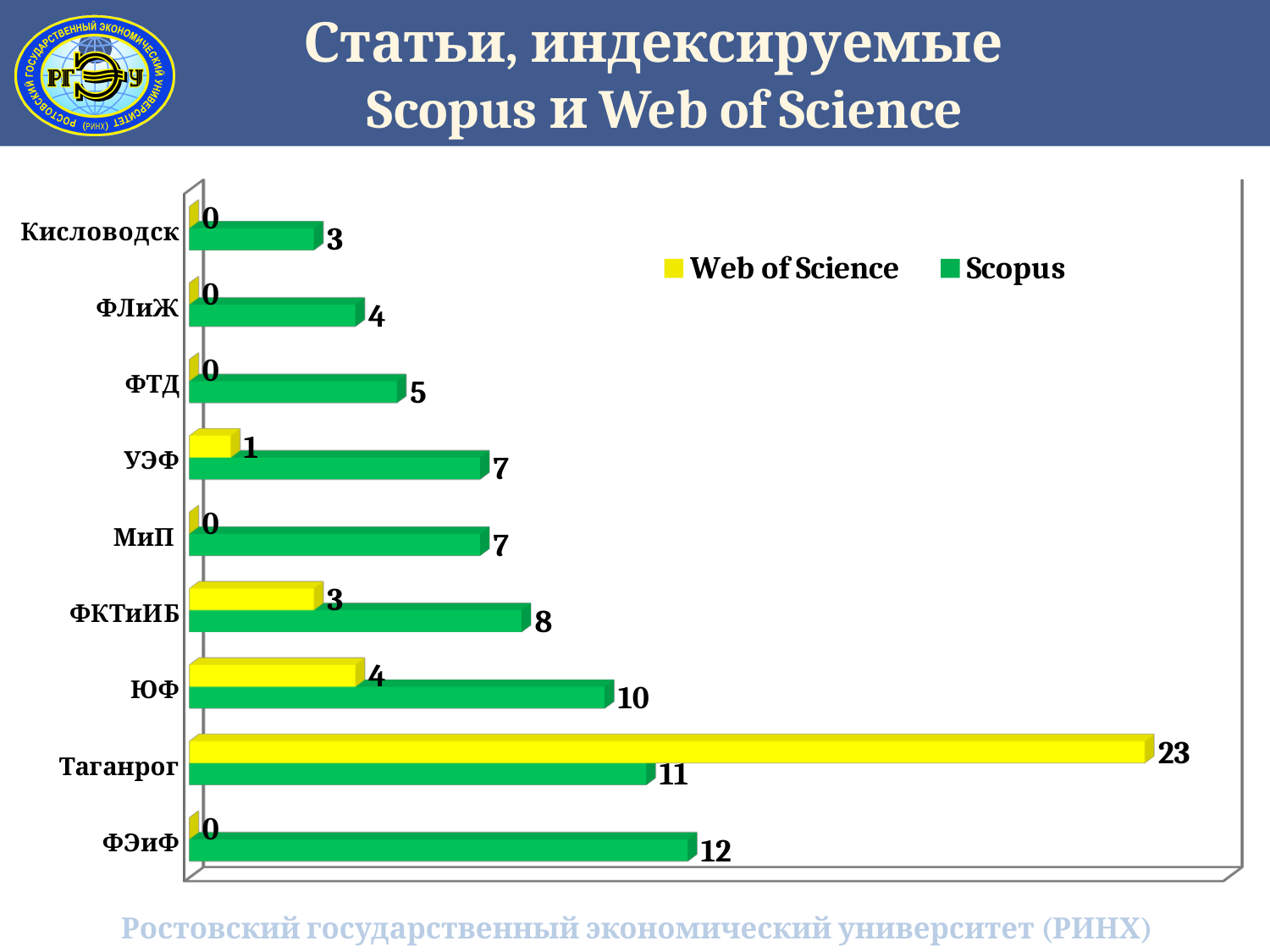
What kind of chart is shown on the slide? Bar chart Which category has the highest Scopus value? ФЭиФ What is the Scopus value for ФЭиФ? 12 What is the difference between the Web of Science and Scopus values for Таганрог? 12 What is the Web of Science value for ФКТиИБ? 3 How many categories are shown on the chart? 9 Which category has the lowest Scopus value? Кисловодск Which is larger for ЮФ: the Scopus value or the Web of Science value? Scopus Which category has the highest Web of Science value? Таганрог What is the Web of Science value for Таганрог? 23 How many series does the legend list? 2 What is the Scopus value for ЮФ? 10